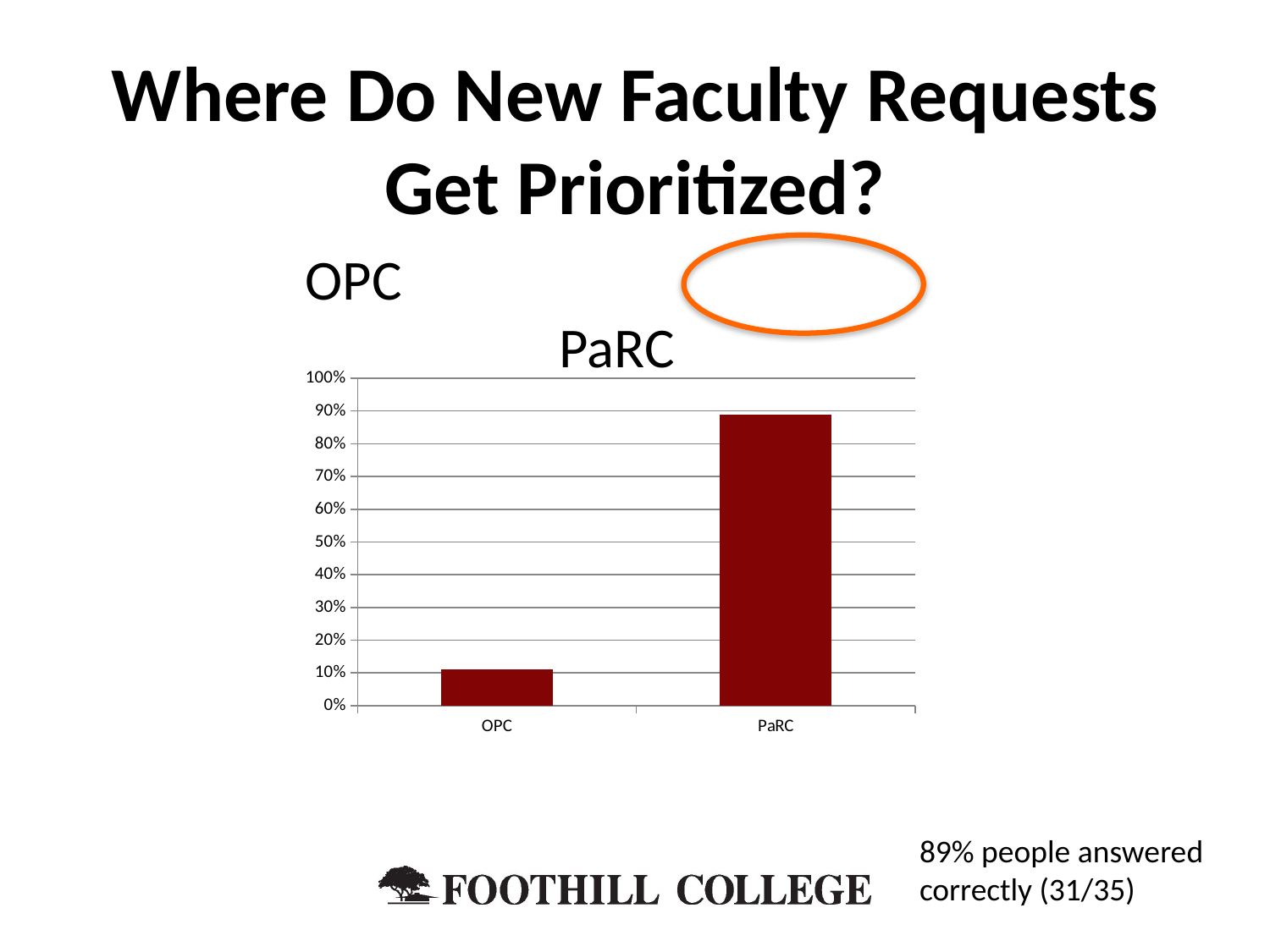
Is the value for PaRC greater or less than 50%? greater What is the maximum value shown on the chart's y axis? 100% Is the value for OPC greater or less than 20%? less How many categories are plotted on the x axis of the chart? 2 Is the value for OPC greater or less than 50%? less What kind of chart is shown on the slide? bar chart What is the title of the slide containing the chart? Where Do New Faculty Requests Get Prioritized? Which category has the highest bar in the chart? PaRC Which is larger, the value for OPC or the value for PaRC? PaRC Which category has the lowest bar in the chart? OPC